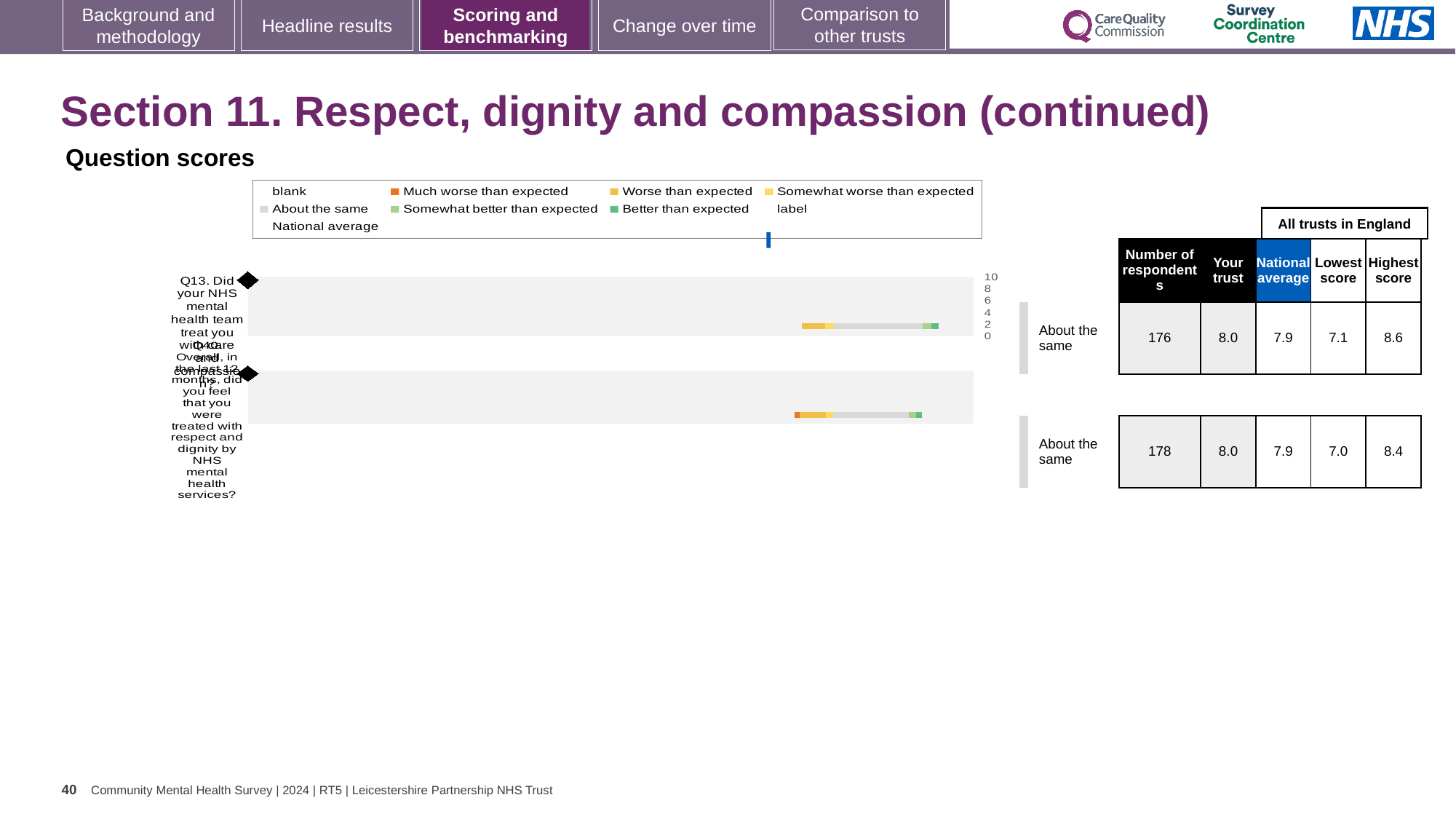
What is the national average score for Q14 (respect and dignity)? 7.9 What kind of chart is used to show the question scores? Bar chart Which legend entry is shown in dark orange? Much worse than expected Which question has the higher 'Highest score' across all trusts, Q13 or Q14? Q13 What is the highest score among all trusts in England for Q13? 8.6 How many questions (categories) are plotted in the Question scores chart? 2 What is the 'Your trust' score for Q13 (care and compassion)? 8.0 How many respondents answered Q14? 178 What is the lowest score among all trusts in England for Q14? 7.0 How is the trust's result for Q13 categorised relative to expectation? About the same What is the difference between the highest and lowest scores for Q14? 1.4 How many respondents answered Q13? 176